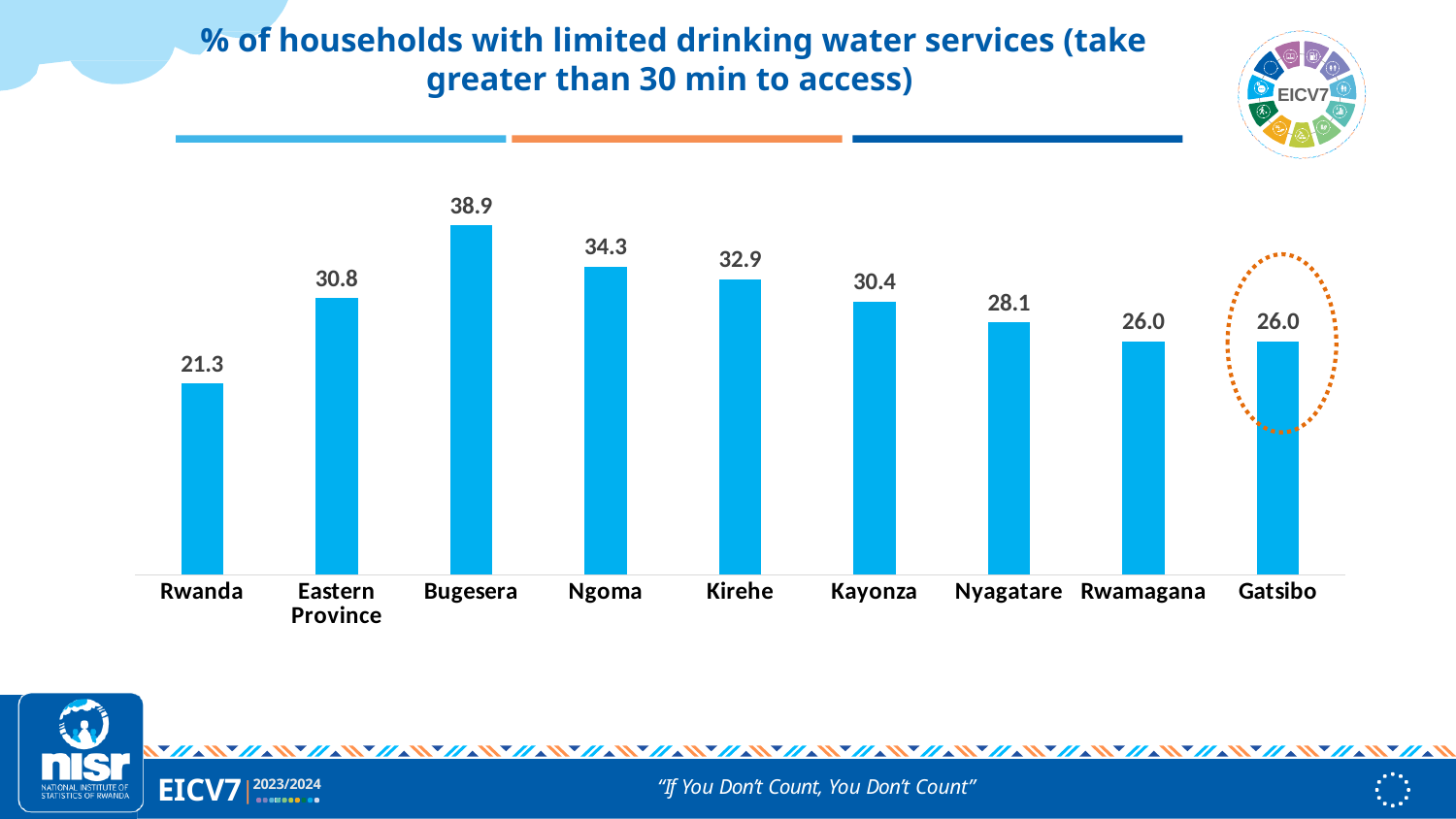
What is the value for Nyagatare? 28.1 What is the difference between the values for Ngoma and Kirehe? 1.4 What kind of chart is shown on the slide? Bar chart What is the value for Gatsibo? 26.0 What is the value for Rwanda? 21.3 What is the difference between the values for Bugesera and Rwanda? 17.6 Which category has the highest value? Bugesera How many categories are shown on the chart? 9 Which category's bar is highlighted with a dotted orange circle? Gatsibo What is the value for Bugesera? 38.9 Which category has the lowest value? Rwanda Which is larger, the value for Eastern Province or the value for Kayonza? Eastern Province